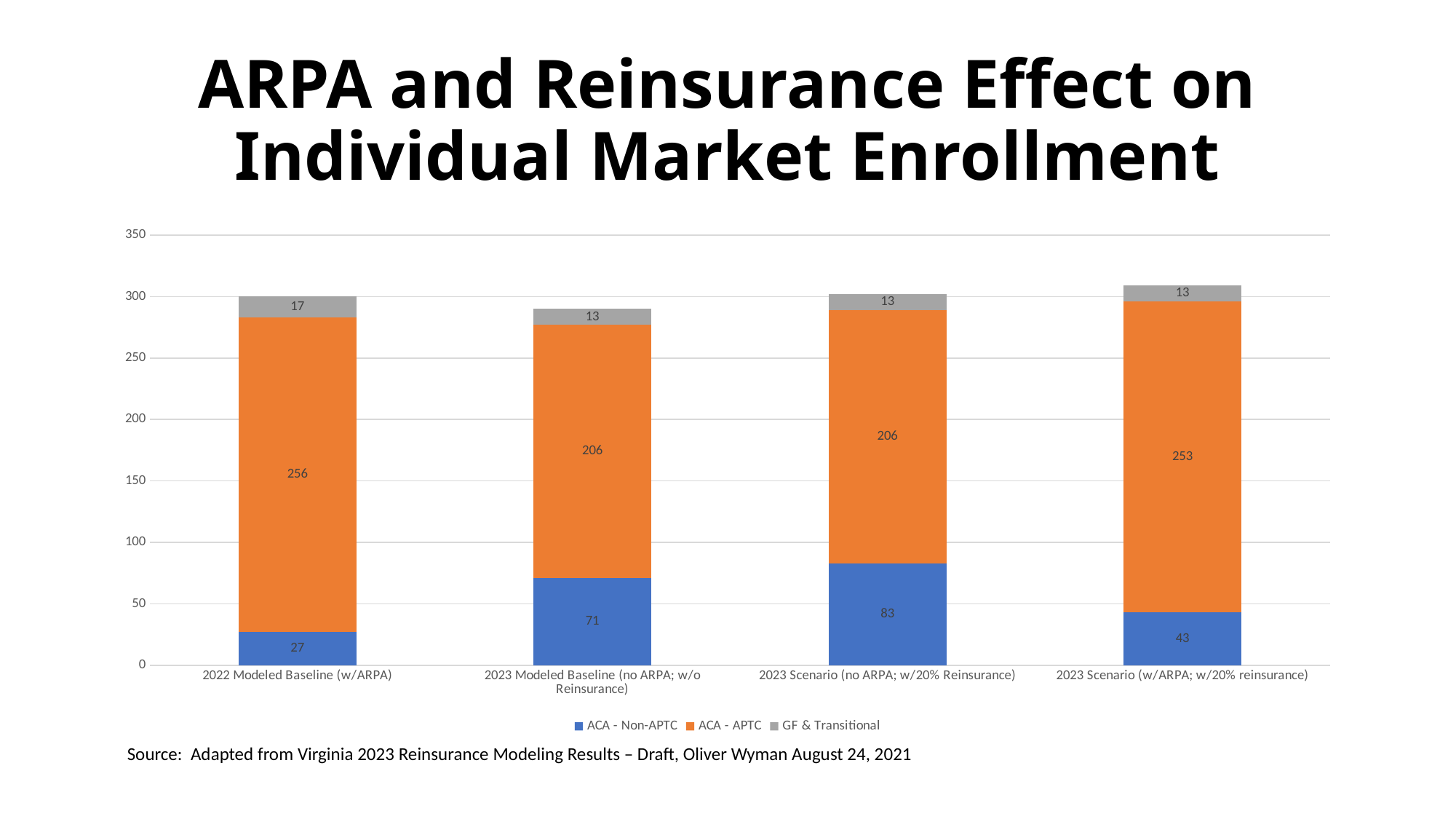
What is the total of the stacked bar for the 2022 Modeled Baseline (w/ARPA)? 300 What is the ACA - APTC value for the 2022 Modeled Baseline (w/ARPA) bar? 256 Which category has the lowest ACA - Non-APTC value? 2022 Modeled Baseline (w/ARPA) Which is larger: the ACA - Non-APTC value for the 2023 Modeled Baseline (no ARPA; w/o Reinsurance) or for the 2023 Scenario (w/ARPA; w/20% reinsurance)? 2023 Modeled Baseline (no ARPA; w/o Reinsurance) How many categories are shown on the x axis? 4 What is the GF & Transitional value for the 2022 Modeled Baseline (w/ARPA) bar? 17 How many series does the legend list? 3 What is the ACA - Non-APTC value for the 2023 Scenario (no ARPA; w/20% Reinsurance) bar? 83 Which category has the highest ACA - Non-APTC value? 2023 Scenario (no ARPA; w/20% Reinsurance) What is the total of the stacked bar for the 2023 Scenario (w/ARPA; w/20% reinsurance)? 309 What kind of chart is shown on the slide? Stacked bar chart What is the difference between the ACA - APTC values for the 2022 Modeled Baseline (w/ARPA) and the 2023 Modeled Baseline (no ARPA; w/o Reinsurance)? 50